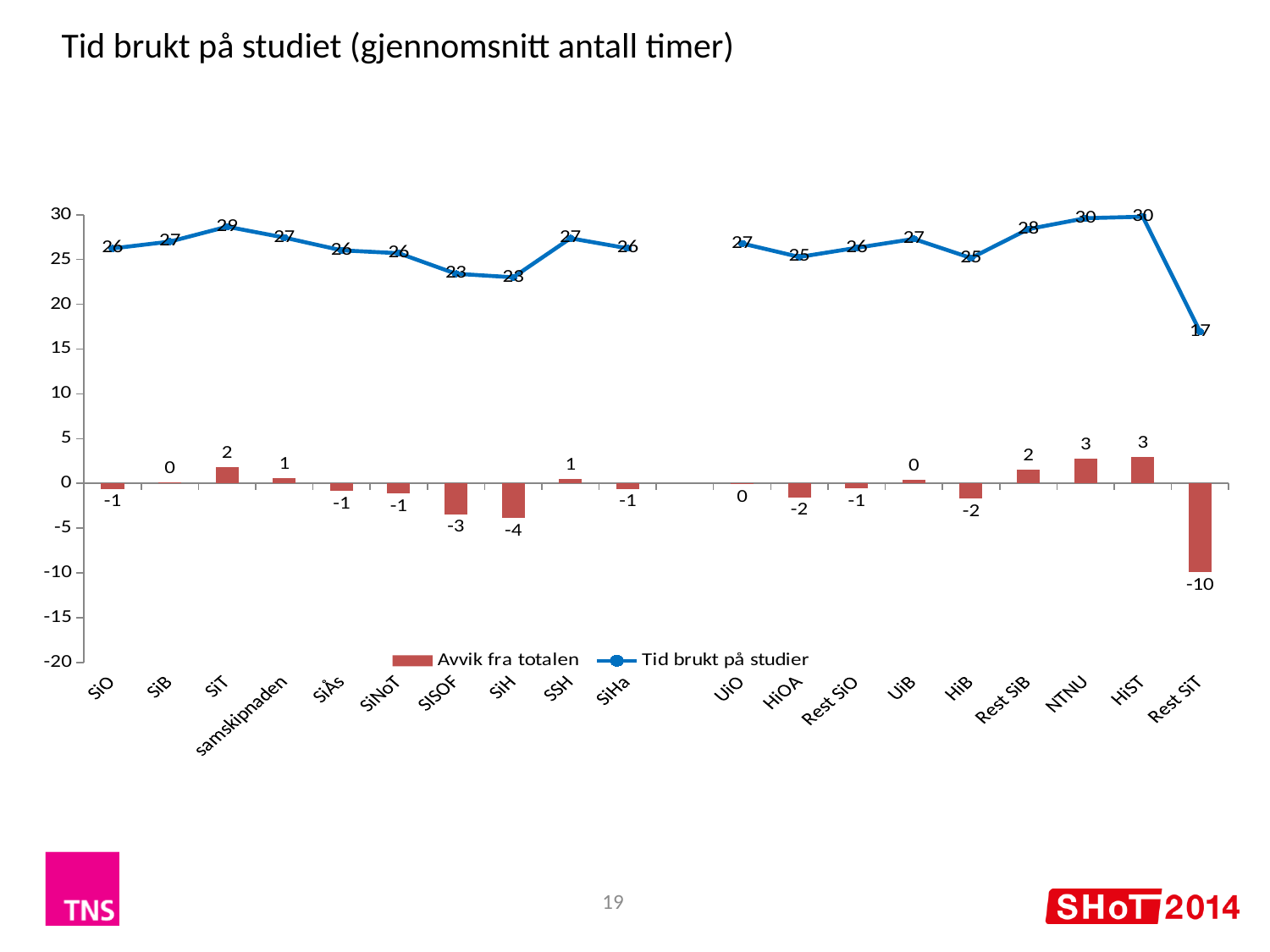
What type of chart is shown on the slide? Combined bar and line chart What is the value of 'Tid brukt på studier' for SiT? 29 What is the 'Avvik fra totalen' value for SiH? -4 What is the title of the chart? Tid brukt på studiet (gjennomsnitt antall timer) What is the difference between the 'Tid brukt på studier' values for HiST and Rest SiT? 13 Which category has the lowest 'Tid brukt på studier' value? Rest SiT Which category has the lowest 'Avvik fra totalen' value? Rest SiT Which has a higher 'Tid brukt på studier' value, SiT or SiH? SiT What is the 'Avvik fra totalen' value for NTNU? 3 How many series does the legend list? 2 What is the 'Avvik fra totalen' value for Rest SiT? -10 What is the 'Tid brukt på studier' value for SiSOF? 23